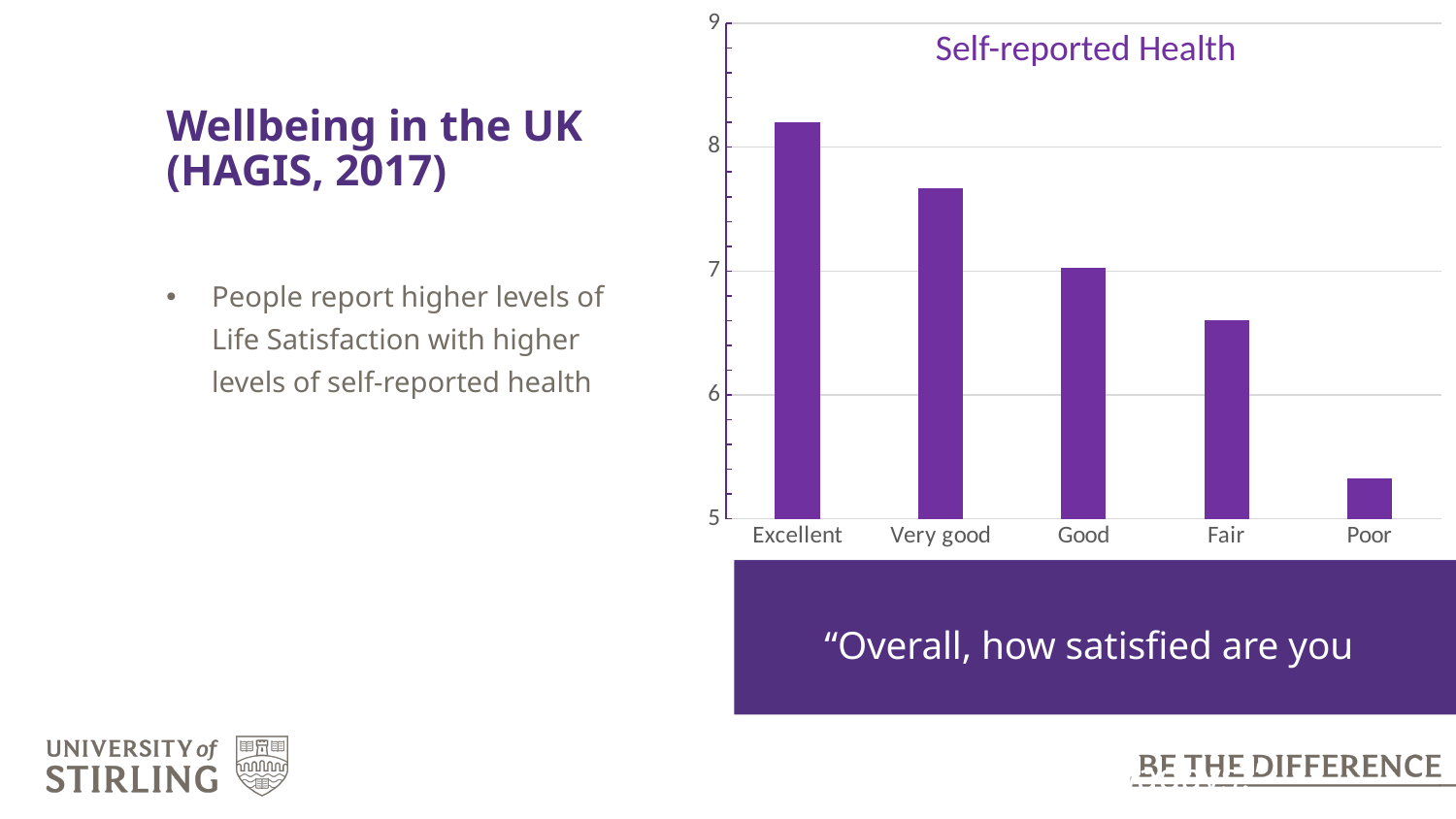
What kind of chart is shown on the slide? bar chart How many categories are shown on the x axis of the chart? 5 Do the bar values rise or fall moving from Excellent to Poor along the x axis? fall Is the value for Fair greater or less than 7? less Which self-reported health category has the highest bar? Excellent What is the title of the chart? Self-reported Health Is the value for Very good greater or less than 8? less What colour are the bars in the chart? purple Is the value for Poor greater or less than 6? less Which self-reported health category has the lowest bar? Poor Which has the larger value, Very good or Fair? Very good